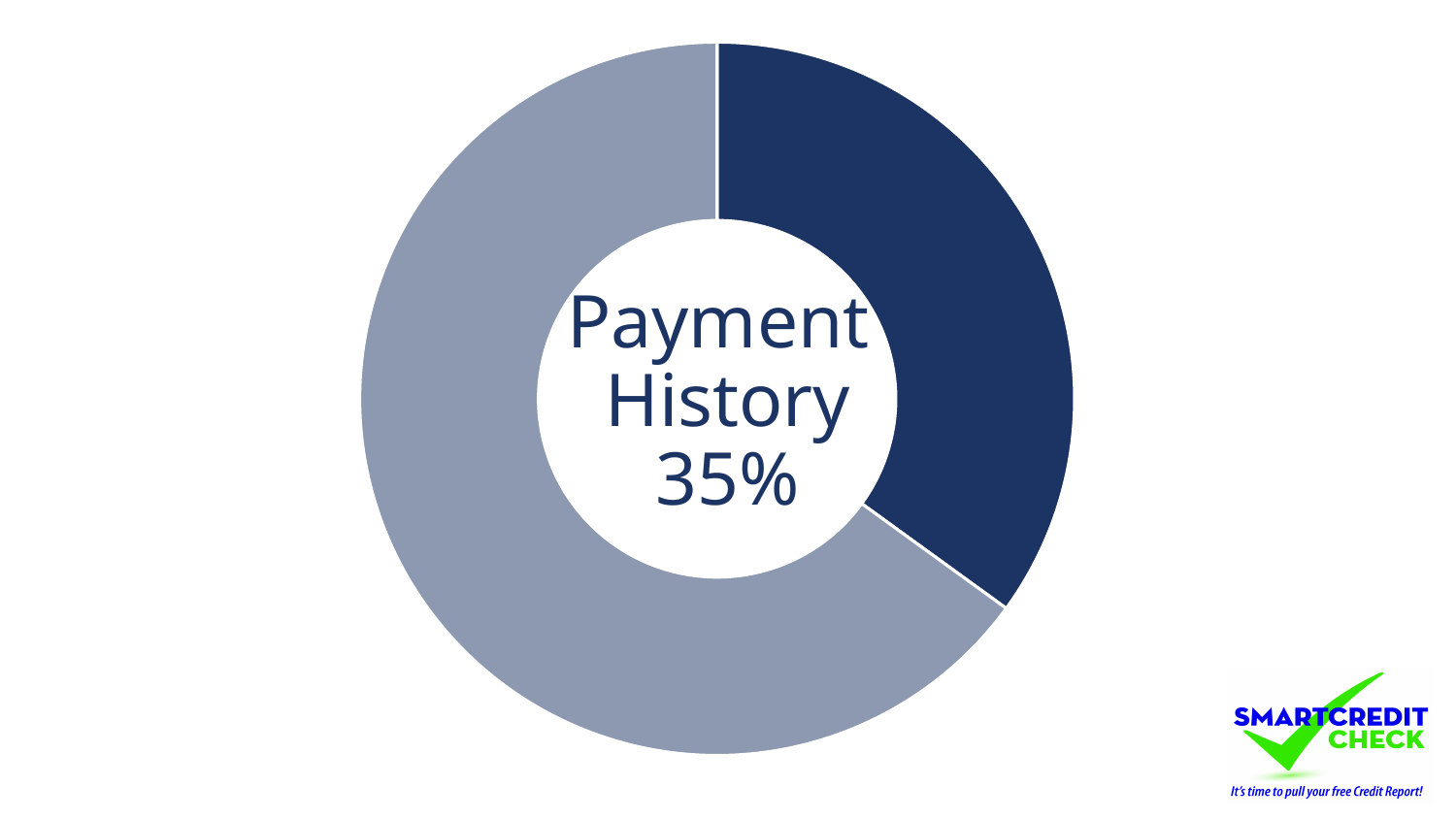
What text is printed in the centre of the donut chart? Payment History 35% What colour is the Payment History slice in the donut chart? dark blue Which slice of the donut chart is the smallest? Payment History (dark blue) What percentage is shown for Payment History in the donut chart? 35% How many slices does the donut chart have? 2 What share of the donut chart does Payment History represent? 35% Is the share for Payment History greater or less than 50%? less Which slice of the donut chart is larger, the dark blue slice or the light grey slice? the light grey slice What kind of chart is shown on the slide? donut chart